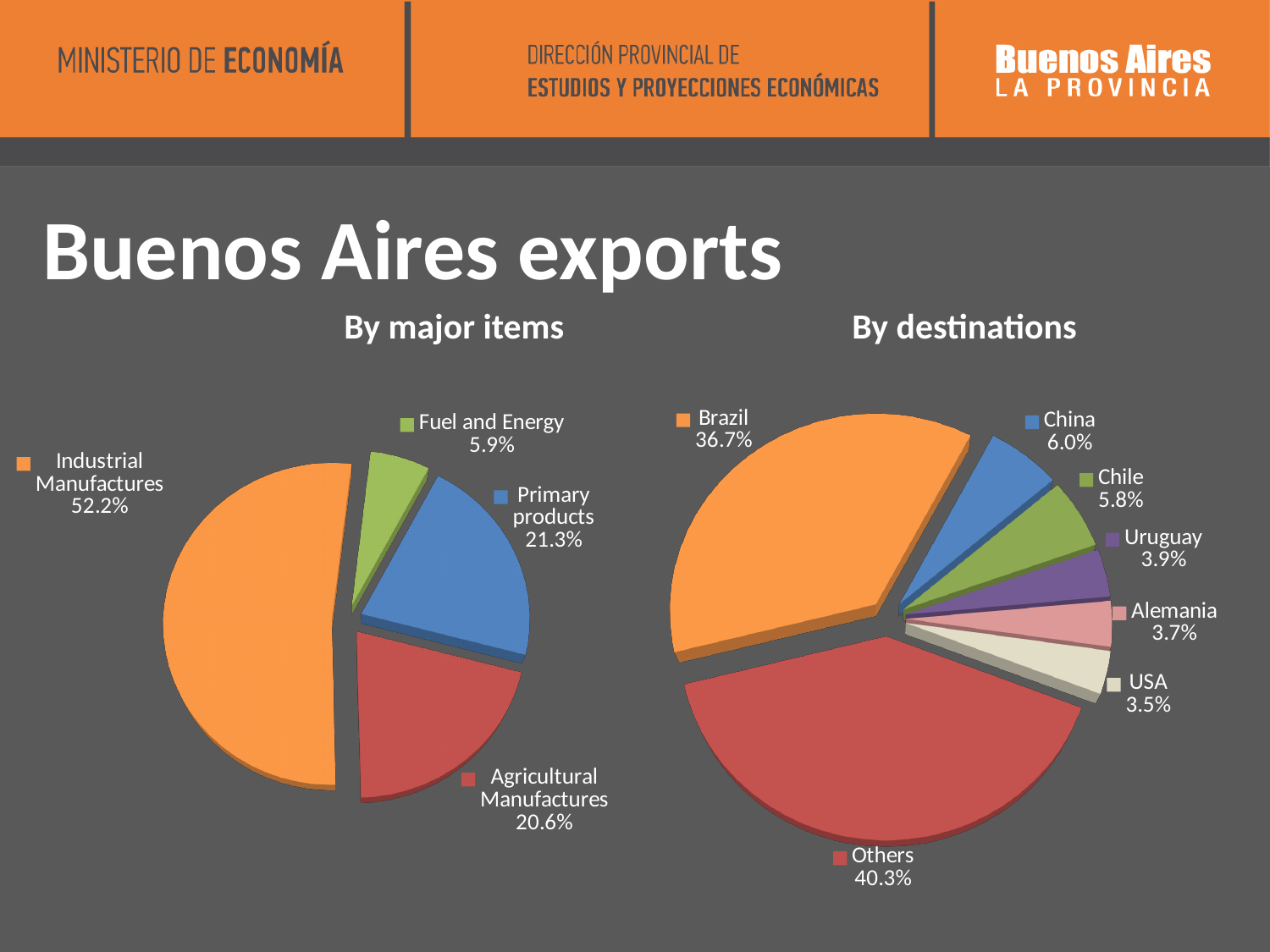
In the 'By destinations' chart, which named destination has the largest share? Brazil In the 'By destinations' chart, how many destinations are shown? 7 In the 'By major items' chart, what share do Industrial Manufactures have? 52.2% In the 'By major items' chart, what is the value for Primary products? 21.3% In the 'By destinations' chart, which is larger, China or Chile? China In the 'By destinations' chart, what share goes to Brazil? 36.7% In the 'By major items' chart, what is the difference between Primary products and Agricultural Manufactures? 0.7% What kind of chart is the 'By destinations' chart? Pie chart In the 'By major items' chart, how many slices does the pie have? 4 In the 'By destinations' chart, what is the difference between Others and Brazil? 3.6% In the 'By destinations' chart, which destination has the smallest share? USA In the 'By major items' chart, which category has the smallest share? Fuel and Energy